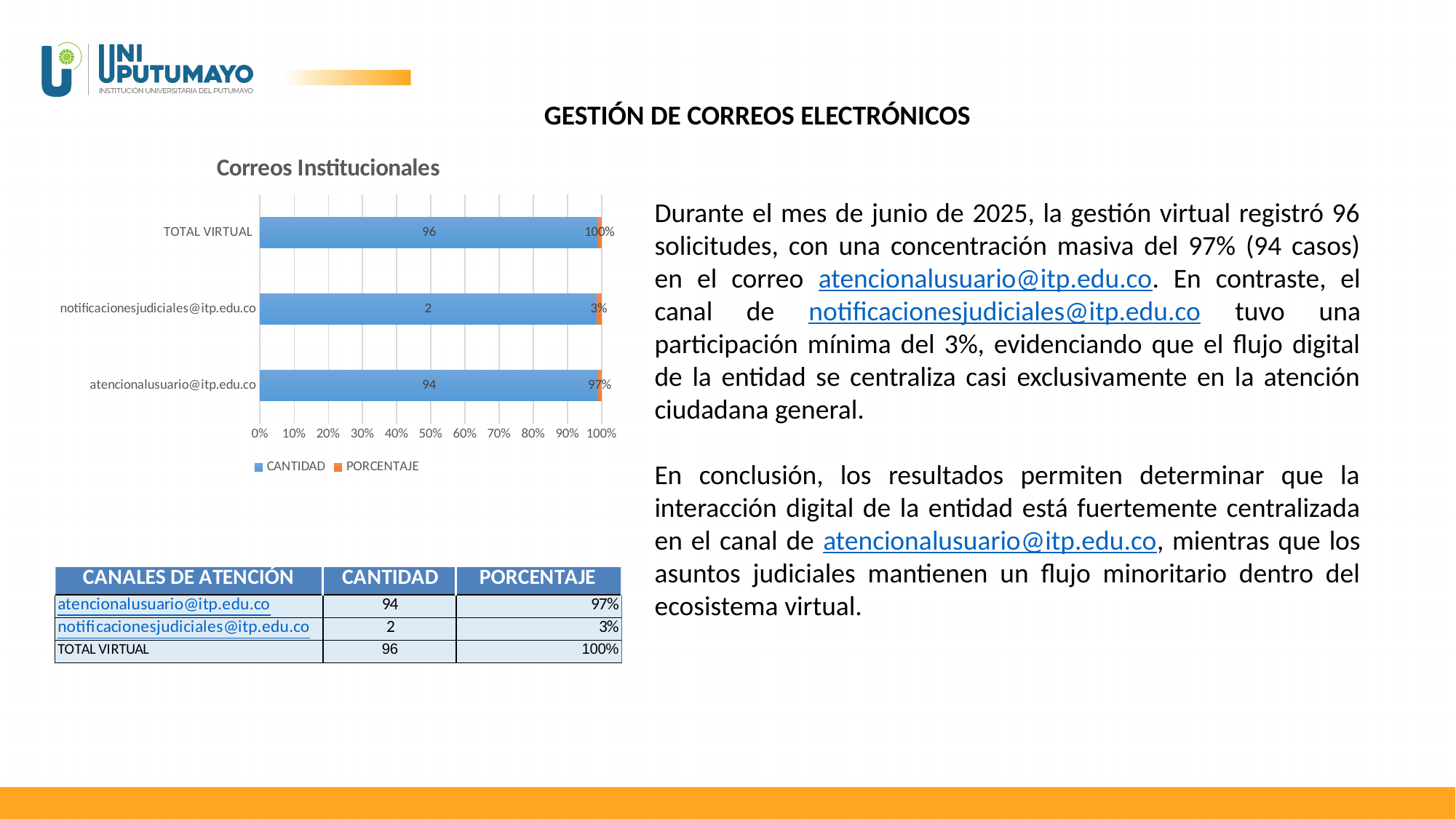
What type of chart is shown on the slide? Bar chart Which has a larger PORCENTAJE value, atencionalusuario@itp.edu.co or notificacionesjudiciales@itp.edu.co? atencionalusuario@itp.edu.co How many series does the chart legend list? 2 How many categories are shown on the chart's vertical axis? 3 What is the PORCENTAJE value for notificacionesjudiciales@itp.edu.co? 3% What are the two series named in the chart legend? CANTIDAD and PORCENTAJE What is the difference in CANTIDAD between atencionalusuario@itp.edu.co and notificacionesjudiciales@itp.edu.co? 92 Which email channel has the lowest CANTIDAD value? notificacionesjudiciales@itp.edu.co What is the CANTIDAD value for atencionalusuario@itp.edu.co? 94 What is the PORCENTAJE value for TOTAL VIRTUAL? 100% What is the CANTIDAD value for notificacionesjudiciales@itp.edu.co? 2 What is the title of the chart? Correos Institucionales